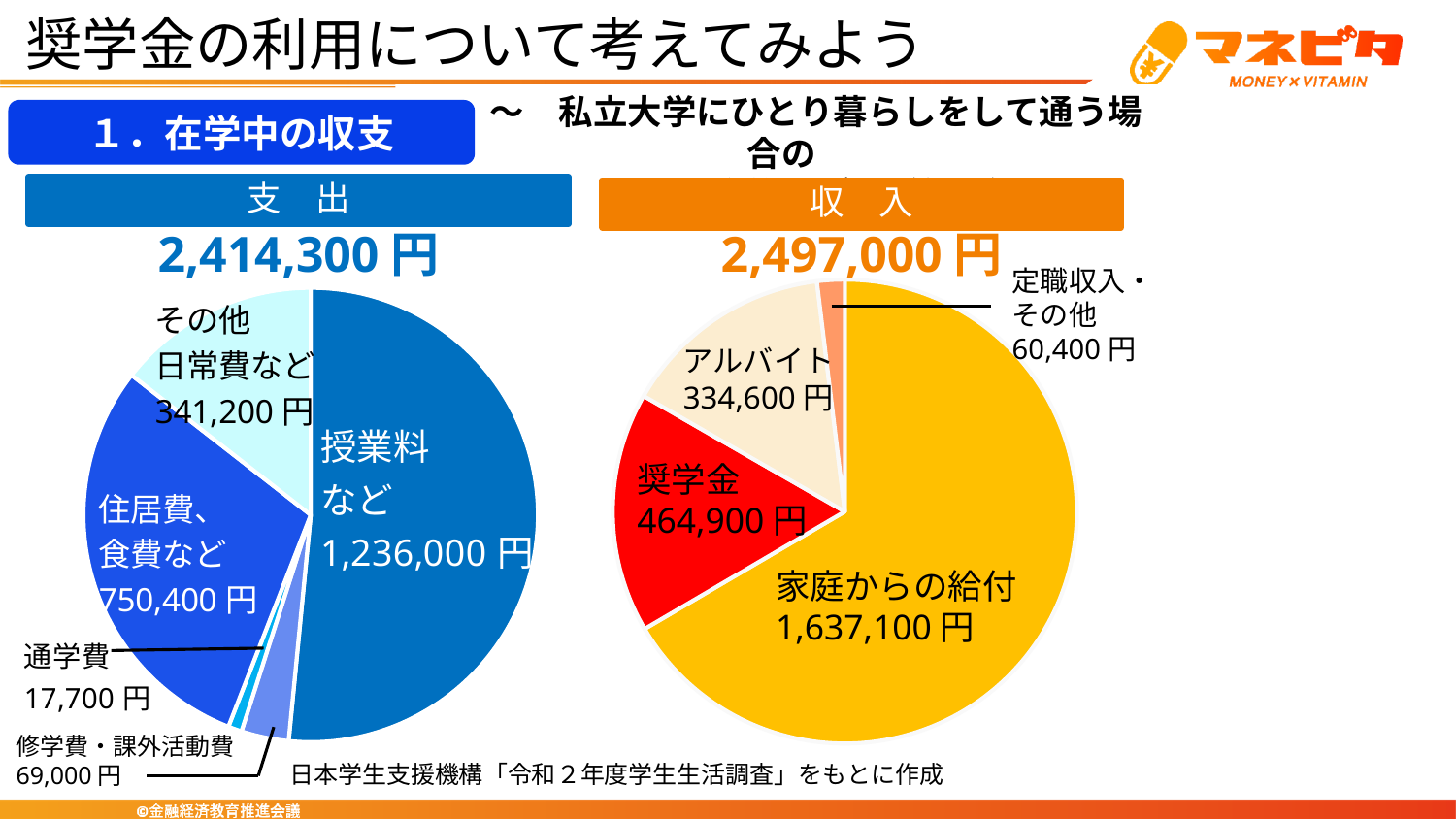
What total is shown above the 収入 pie chart? 2,497,000 円 In the 収入 pie chart, what is the difference between 家庭からの給付 and 奨学金? 1,172,200 円 In the 収入 pie chart, which category has the smallest value? 定職収入・その他 In the 収入 pie chart, what is the value for 奨学金? 464,900 円 How many categories does the 支出 pie chart show? 5 In the 支出 pie chart, which category has the largest value? 授業料など What kind of chart is used for 支出? Pie chart In the 支出 pie chart, which category has the smallest value? 通学費 In the 支出 pie chart, what is the value for 授業料など? 1,236,000 円 How many categories does the 収入 pie chart show? 4 In the 収入 pie chart, what is the value for アルバイト? 334,600 円 In the 支出 pie chart, which is larger: 住居費、食費など or その他日常費など? 住居費、食費など